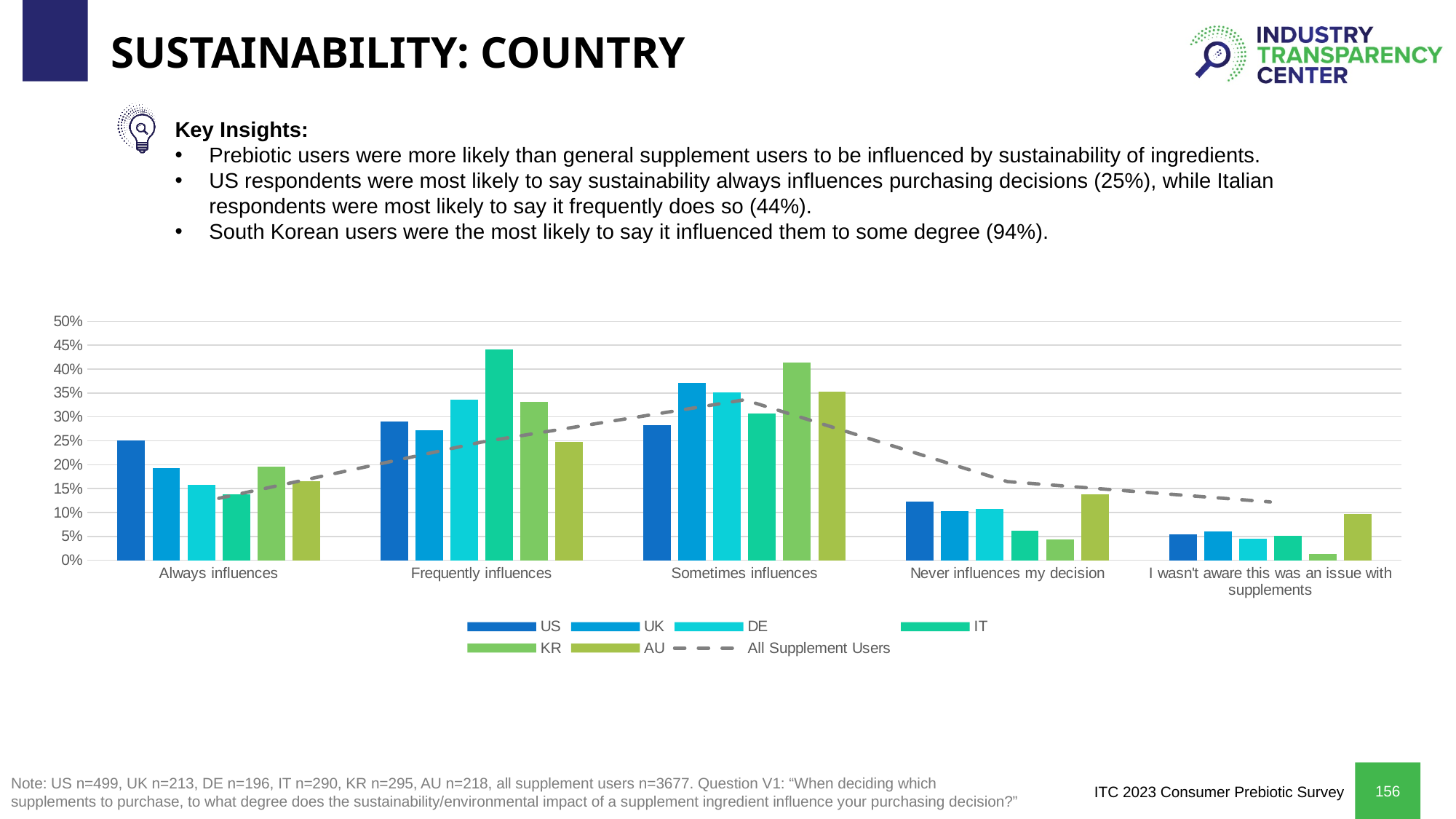
In the 'Always influences' category, which is larger: the value for US or the value for KR? US What is the value for US in the 'Always influences' category? 25% What kind of chart is shown on the slide? Combination bar and line chart (bars with a dashed line) Which series is drawn as a dashed line rather than bars? All Supplement Users Which country has the highest bar in the 'Sometimes influences' category? KR How many response categories are shown along the x axis? 5 Which country has the highest bar in the 'Always influences' category? US Is the value for IT in 'Frequently influences' greater or less than 40%? greater How many series does the legend list? 7 Is the value for KR in 'I wasn't aware this was an issue with supplements' greater or less than 5%? less Which country has the lowest bar in the 'I wasn't aware this was an issue with supplements' category? KR Which country has the highest bar in the 'Frequently influences' category? IT